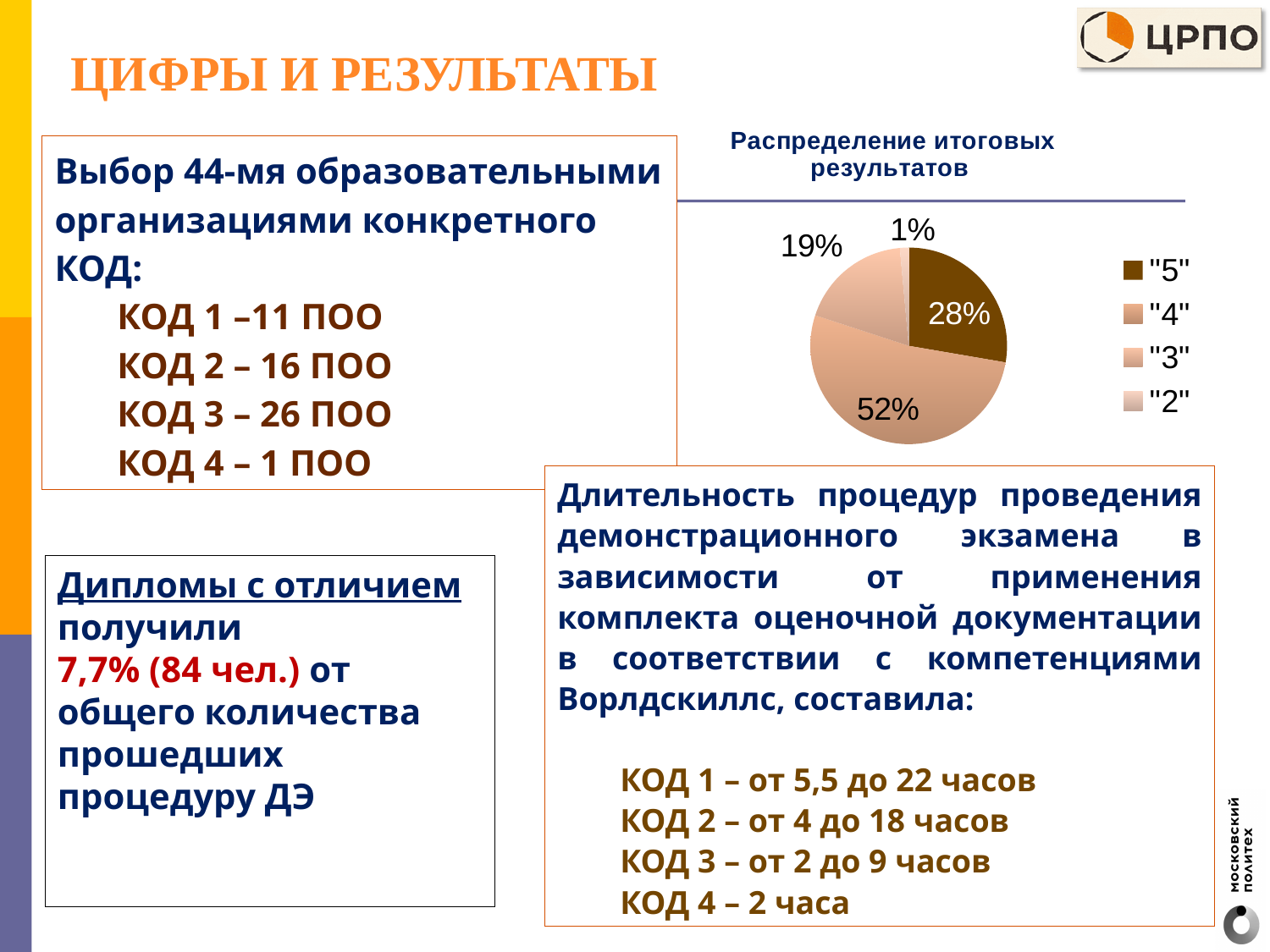
In the pie chart "Распределение итоговых результатов", what share does the "2" slice have? 1% In the pie chart "Распределение итоговых результатов", what is the combined share of the "5" and "4" slices? 80% What type of chart is shown under the title "Распределение итоговых результатов"? pie chart What is the title of the pie chart on the slide? Распределение итоговых результатов In the pie chart "Распределение итоговых результатов", what share does the "4" slice have? 52% In the pie chart "Распределение итоговых результатов", which category has the largest share? "4" In the pie chart "Распределение итоговых результатов", which is larger: the share for "5" or the share for "3"? "5" In the pie chart "Распределение итоговых результатов", which category has the smallest share? "2" In the pie chart "Распределение итоговых результатов", how many categories does the legend list? 4 In the pie chart "Распределение итоговых результатов", what is the difference in percentage points between the "4" slice and the "5" slice? 24 In the pie chart "Распределение итоговых результатов", what share does the "3" slice have? 19% In the pie chart "Распределение итоговых результатов", what share does the "5" slice have? 28%